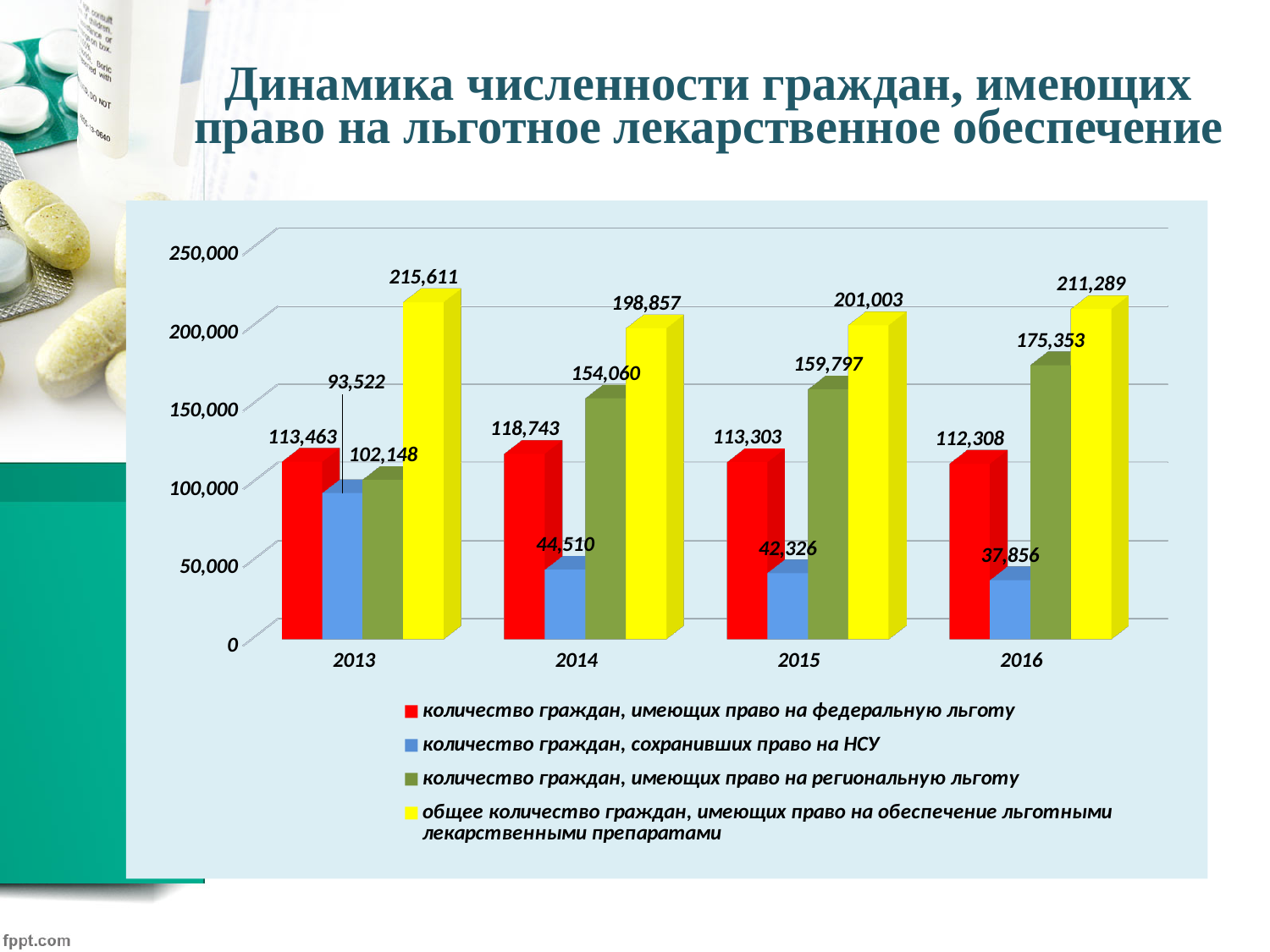
What is the value for 'количество граждан, имеющих право на региональную льготу' in 2015? 159,797 In which year is the value for 'количество граждан, сохранивших право на НСУ' lowest? 2016 What type of chart is shown on the slide? bar chart Which colour represents 'количество граждан, сохранивших право на НСУ' in the legend? blue What is the value for 'общее количество граждан, имеющих право на обеспечение льготными лекарственными препаратами' in 2013? 215,611 Which is larger: the 'количество граждан, имеющих право на региональную льготу' value in 2014 or in 2016? 2016 What is the difference between the 'общее количество граждан' values for 2013 and 2014? 16,754 What is the value for 'количество граждан, сохранивших право на НСУ' in 2016? 37,856 How many years are shown on the x axis? 4 How many series does the legend list? 4 In which year is the value for 'количество граждан, имеющих право на федеральную льготу' highest? 2014 Does the value for 'количество граждан, имеющих право на региональную льготу' rise or fall from 2013 to 2016? rise